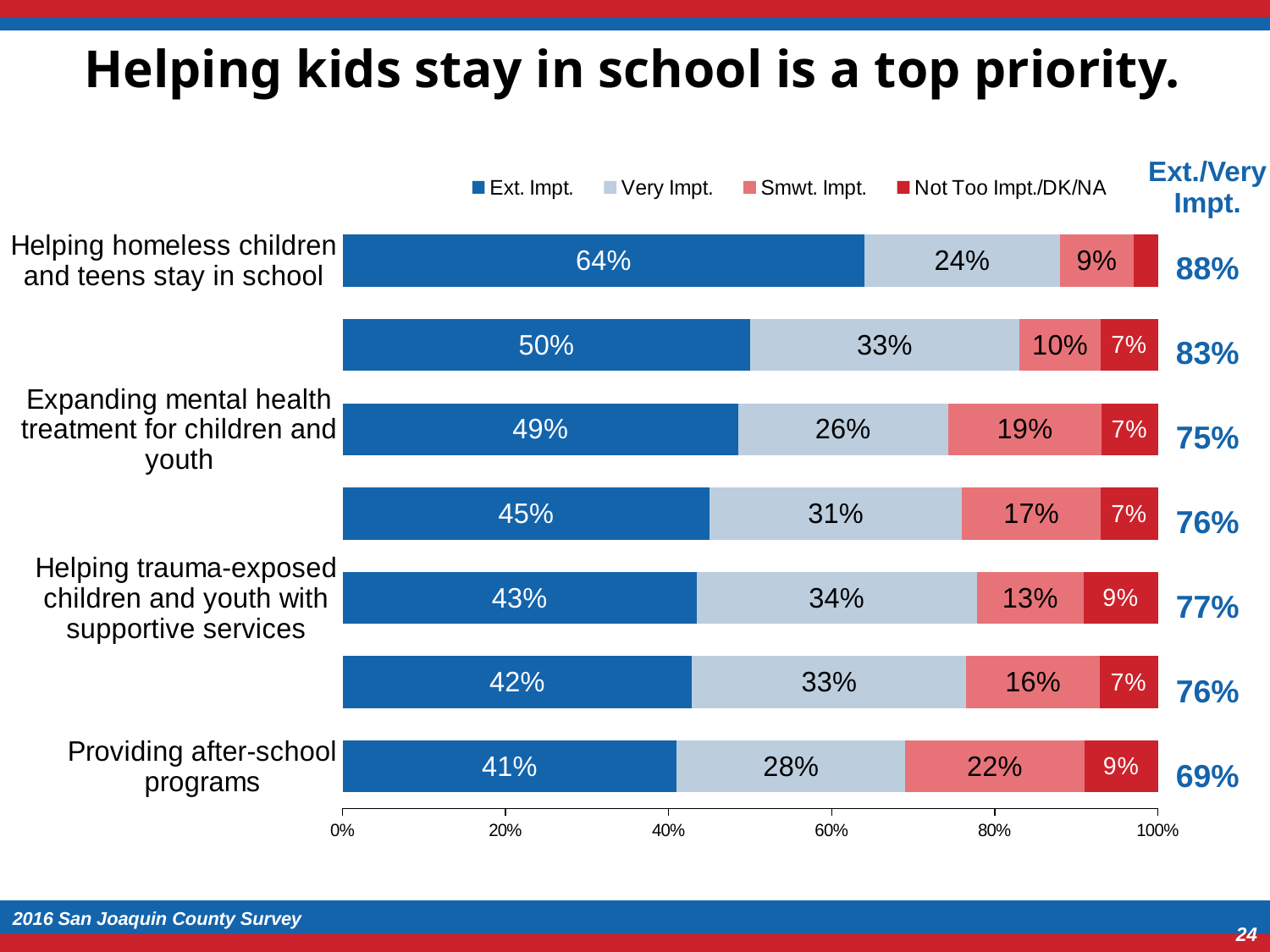
What is the Not Too Impt./DK/NA value for 'Helping trauma-exposed children and youth with supportive services'? 9% What percentage rated 'Helping homeless children and teens stay in school' as Ext. Impt.? 64% How many series does the legend list? 4 What type of chart is shown on the slide? Stacked bar chart What is the Very Impt. value for 'Providing after-school programs'? 28% What is the total of the Ext. Impt. and Very Impt. segments for 'Providing after-school programs'? 69% Which category has the lowest Ext. Impt. percentage? Providing after-school programs Which category has the highest Ext. Impt. percentage? Helping homeless children and teens stay in school How many percentage points higher is the Ext. Impt. value for 'Helping homeless children and teens stay in school' than for 'Providing after-school programs'? 23 percentage points Which has a larger Very Impt. value: 'Helping trauma-exposed children and youth with supportive services' or 'Expanding mental health treatment for children and youth'? Helping trauma-exposed children and youth with supportive services What is the Smwt. Impt. value for 'Expanding mental health treatment for children and youth'? 19% What is the combined Ext./Very Impt. figure shown for 'Helping homeless children and teens stay in school'? 88%